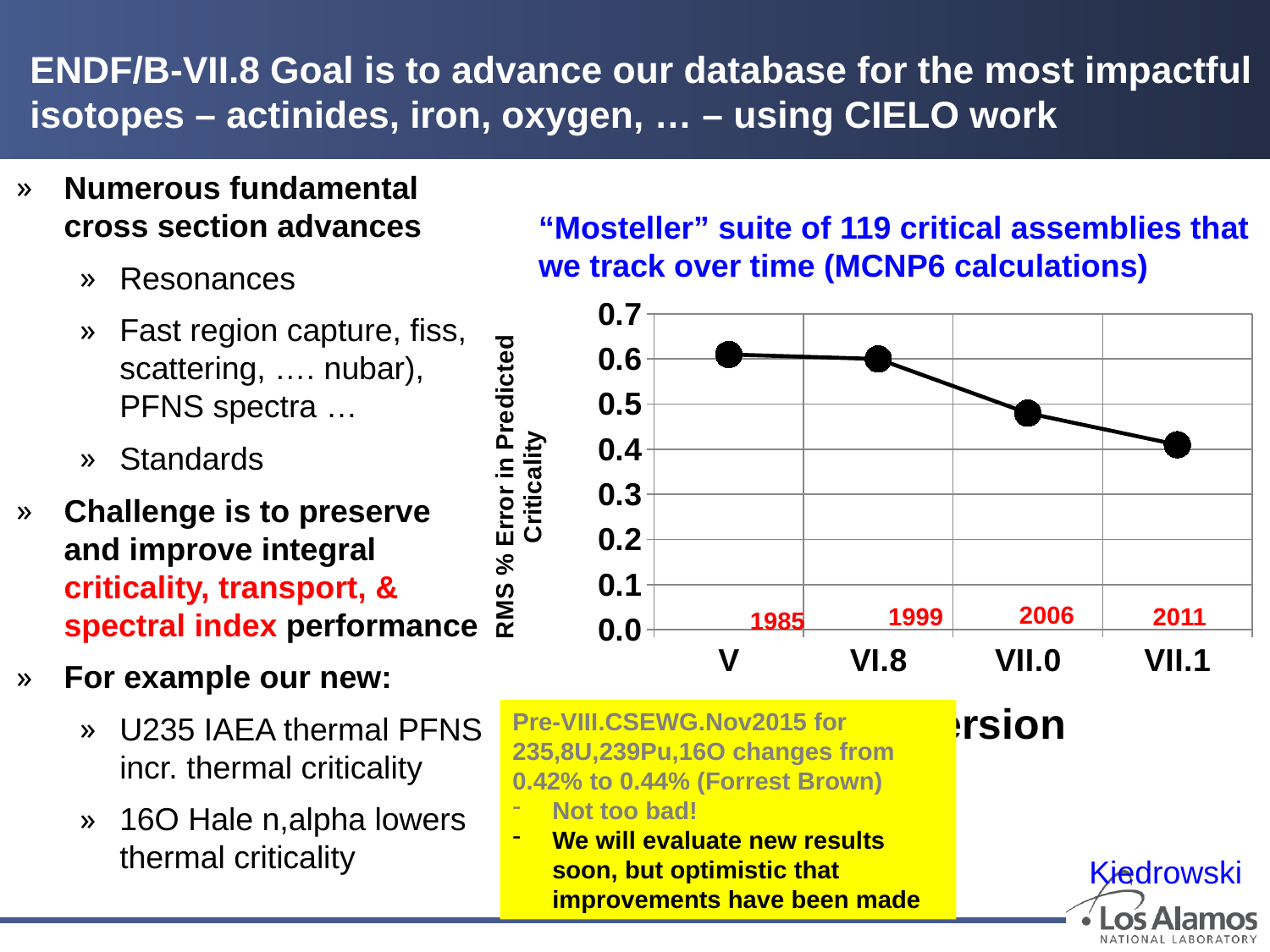
Is the RMS % error for version VI.8 greater or less than 0.5? greater Which has a larger RMS % error, version VI.8 or version VII.0? VI.8 Do the values rise or fall from version V to version VII.1 along the x axis? fall What is the label of the y axis? RMS % Error in Predicted Criticality Is the RMS % error for version V greater or less than 0.5? greater Is the RMS % error for version VII.1 greater or less than 0.5? less Which has a larger RMS % error, version V or version VII.1? V What year is shown beneath the VII.0 point on the x axis? 2006 How many data points are plotted on the chart? 4 What kind of chart is shown on the slide? line chart Which ENDF/B version has the lowest RMS % error in predicted criticality? VII.1